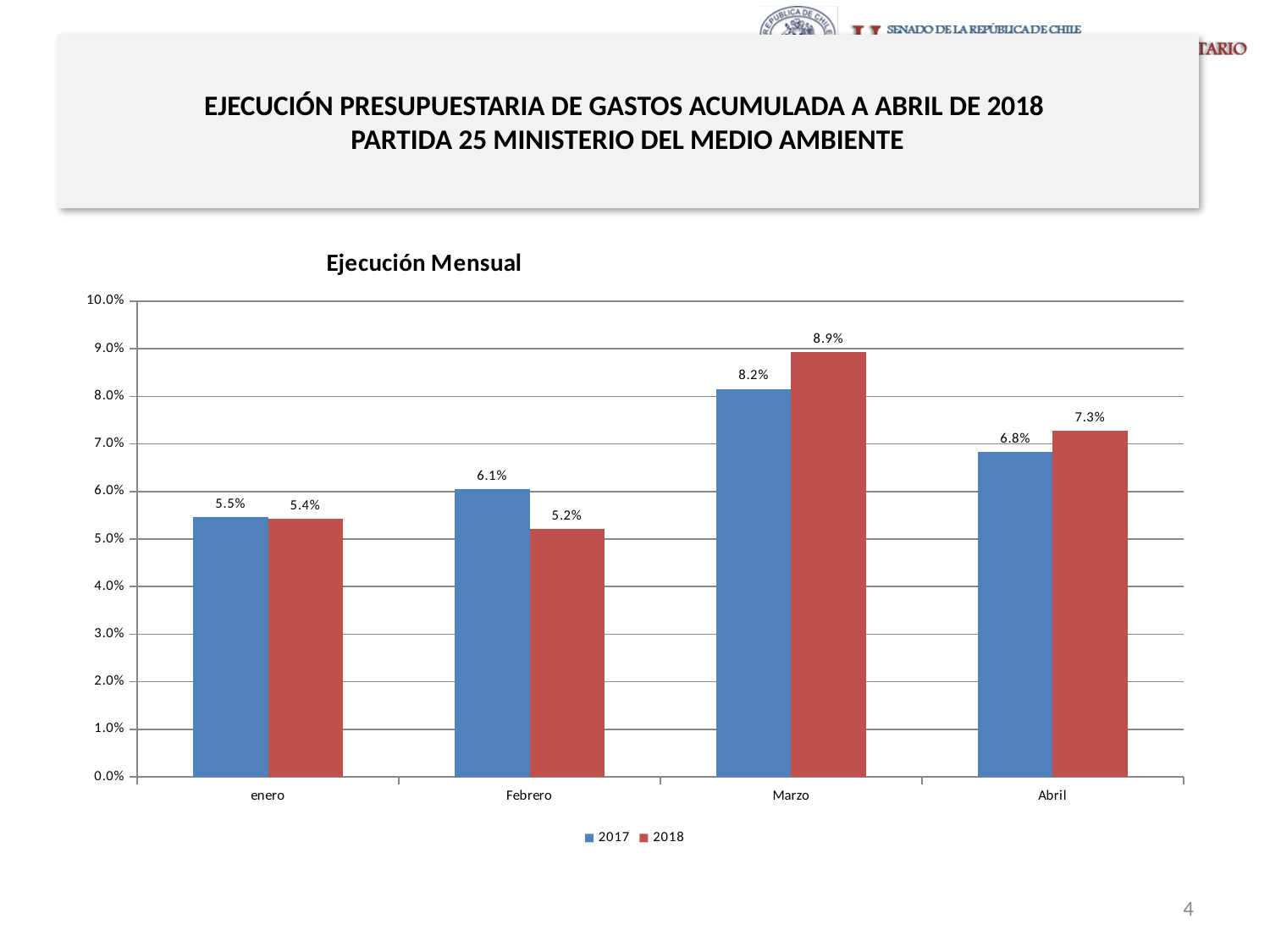
Is the value for 2017 in Abril greater or less than 7.0%? less What is the difference between the 2018 and 2017 values in Marzo? 0.7% Which is larger in Febrero, the 2017 value or the 2018 value? 2017 How many months are shown on the x axis? 4 What is the value for 2018 in Marzo? 8.9% How many series does the legend list? 2 What is the value for 2018 in Abril? 7.3% Which month has the highest value for the 2017 series? Marzo What is the value for 2017 in Febrero? 6.1% What is the title of the chart? Ejecución Mensual Which month has the lowest value for the 2018 series? Febrero What kind of chart is shown? bar chart